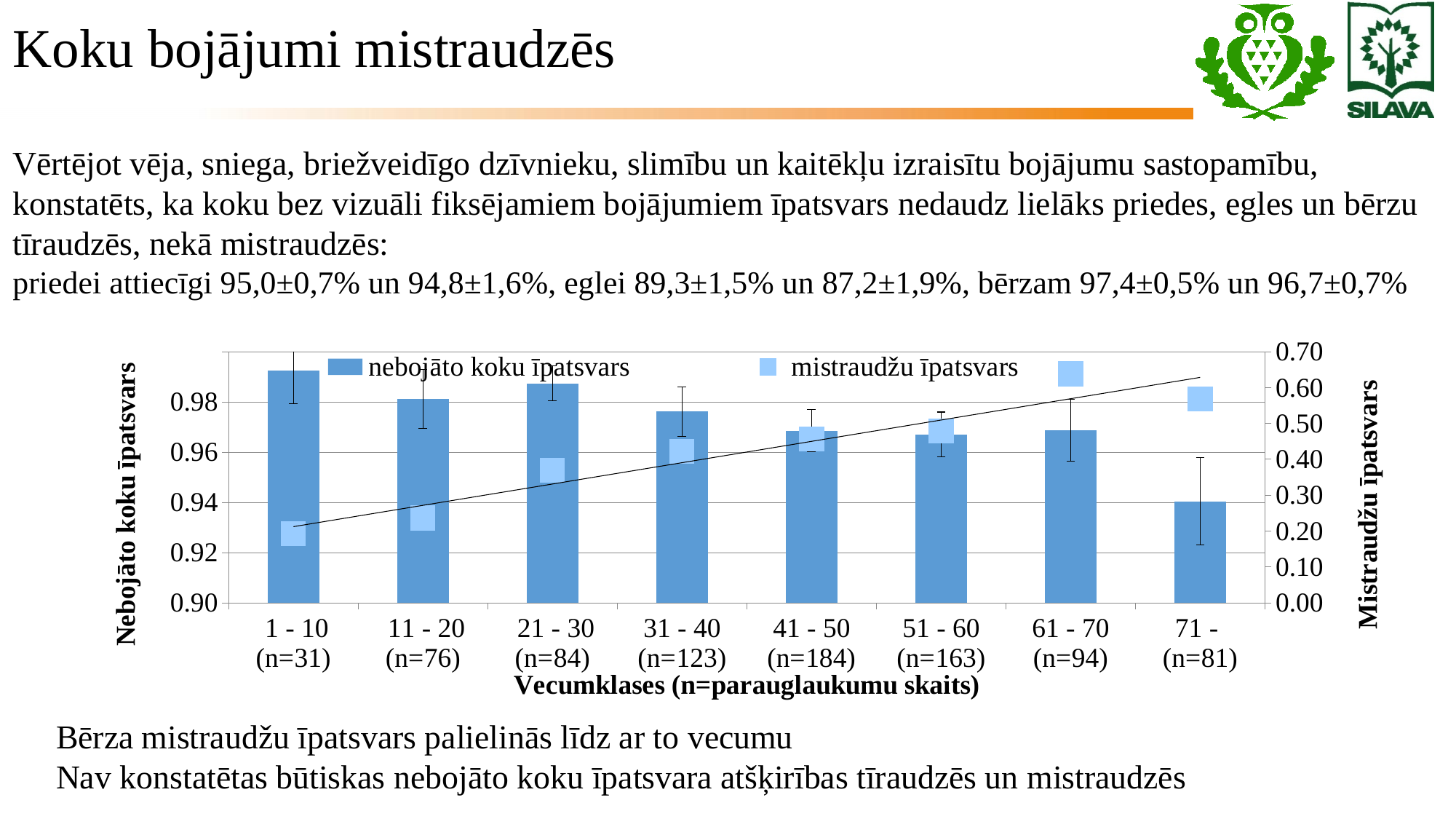
How many age classes (categories) are shown on the x axis? 8 Which has the larger nebojāto koku īpatsvars bar: the 1 - 10 age class or the 71 - age class? 1 - 10 What kind of chart is shown on the slide? bar chart Does the mistraudžu īpatsvars generally rise or fall as the age class increases along the x axis? rise Is the nebojāto koku īpatsvars bar for the 71 - age class greater or less than 0.96? less How many series does the legend list? 2 What is the title of the x axis of the chart? Vecumklases (n=parauglaukumu skaits) Is the mistraudžu īpatsvars marker for the 61 - 70 age class greater or less than 0.60 on the right axis? greater Which age class has the lowest bar for nebojāto koku īpatsvars? 71 - (n=81) Is the mistraudžu īpatsvars marker for the 1 - 10 age class greater or less than 0.30 on the right axis? less Which age class has the highest bar for nebojāto koku īpatsvars? 1 - 10 (n=31)